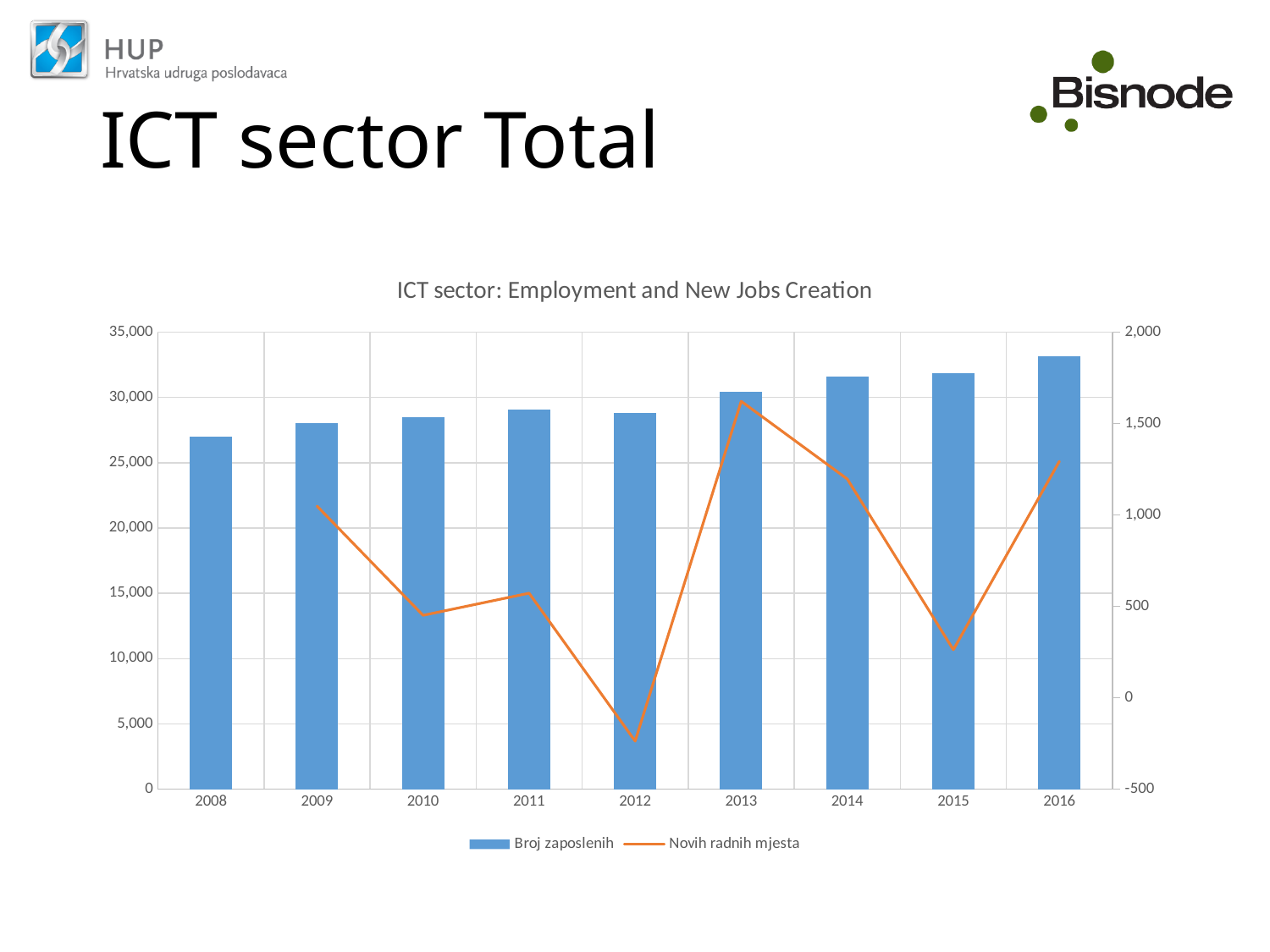
What kind of chart is shown on the slide? A combined bar and line chart Which year has the larger Broj zaposlenih bar, 2008 or 2013? 2013 In which year does the Novih radnih mjesta line reach its lowest point? 2012 Is the Broj zaposlenih value for 2016 greater or less than 30,000? greater How many series does the legend list? 2 Which year has the highest bar for Broj zaposlenih? 2016 Which year has the lowest bar for Broj zaposlenih? 2008 What is the title of the chart? ICT sector: Employment and New Jobs Creation How many years are shown on the x axis? 9 Do the Broj zaposlenih bars generally rise or fall from 2008 to 2016? rise Is the Novih radnih mjesta value for 2012 greater or less than 0? less In which year does the Novih radnih mjesta line reach its highest point? 2013